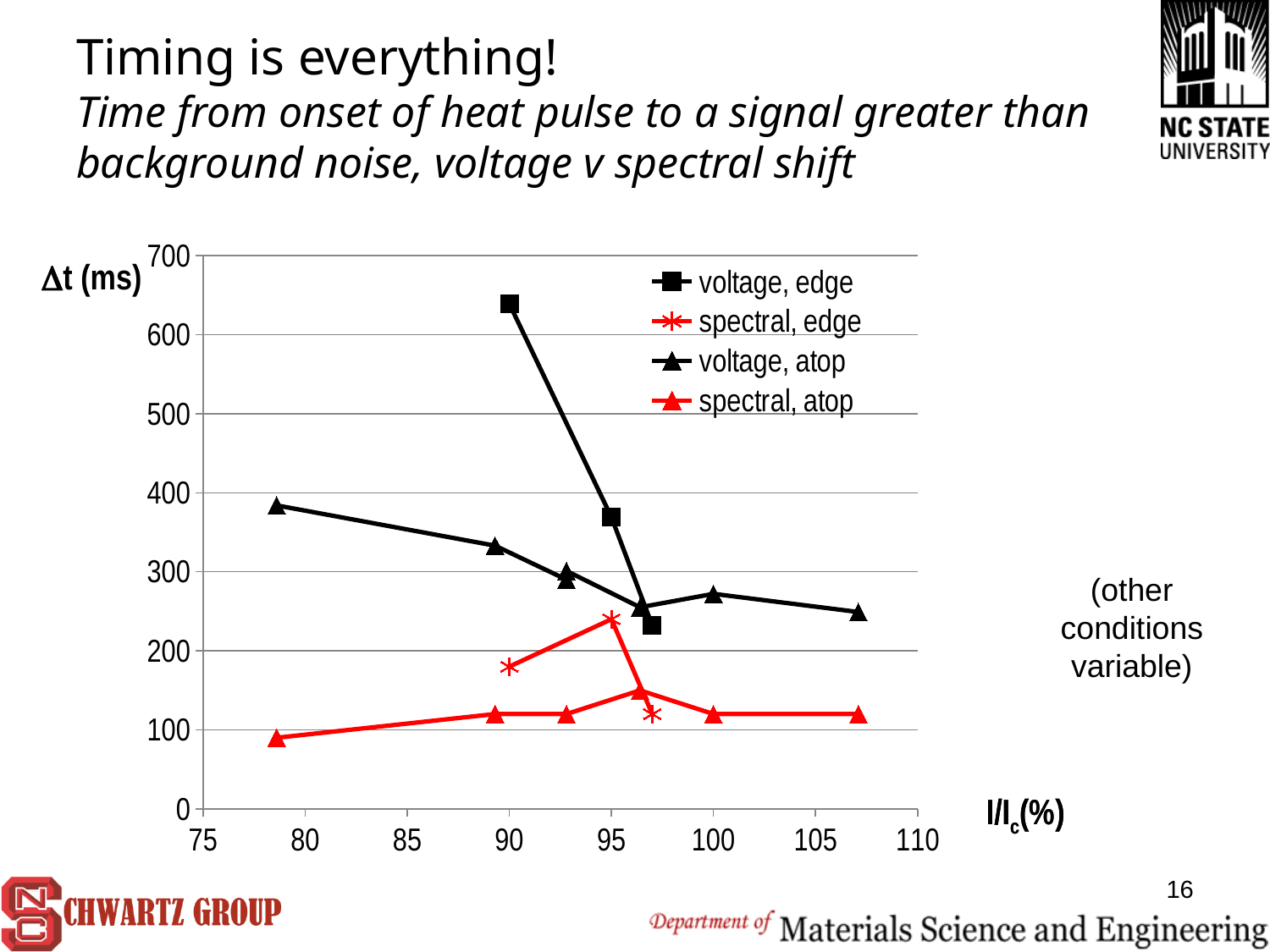
Is the highest value of the spectral, edge series greater or less than 200? greater Is the first (leftmost) value of the voltage, atop series greater or less than 400? less Does the voltage, edge series rise or fall as I/Ic increases? fall Is the highest value of the voltage, edge series greater or less than 600? greater How many data points does the voltage, edge series have? 3 At I/Ic = 100%, which series has the larger Δt: voltage, atop or spectral, atop? voltage, atop Which series contains the lowest Δt value on the chart? spectral, atop How many series does the legend list? 4 What is the label on the vertical axis? Δt (ms) Which series reaches the highest Δt value on the chart? voltage, edge What kind of chart is shown on the slide? line chart